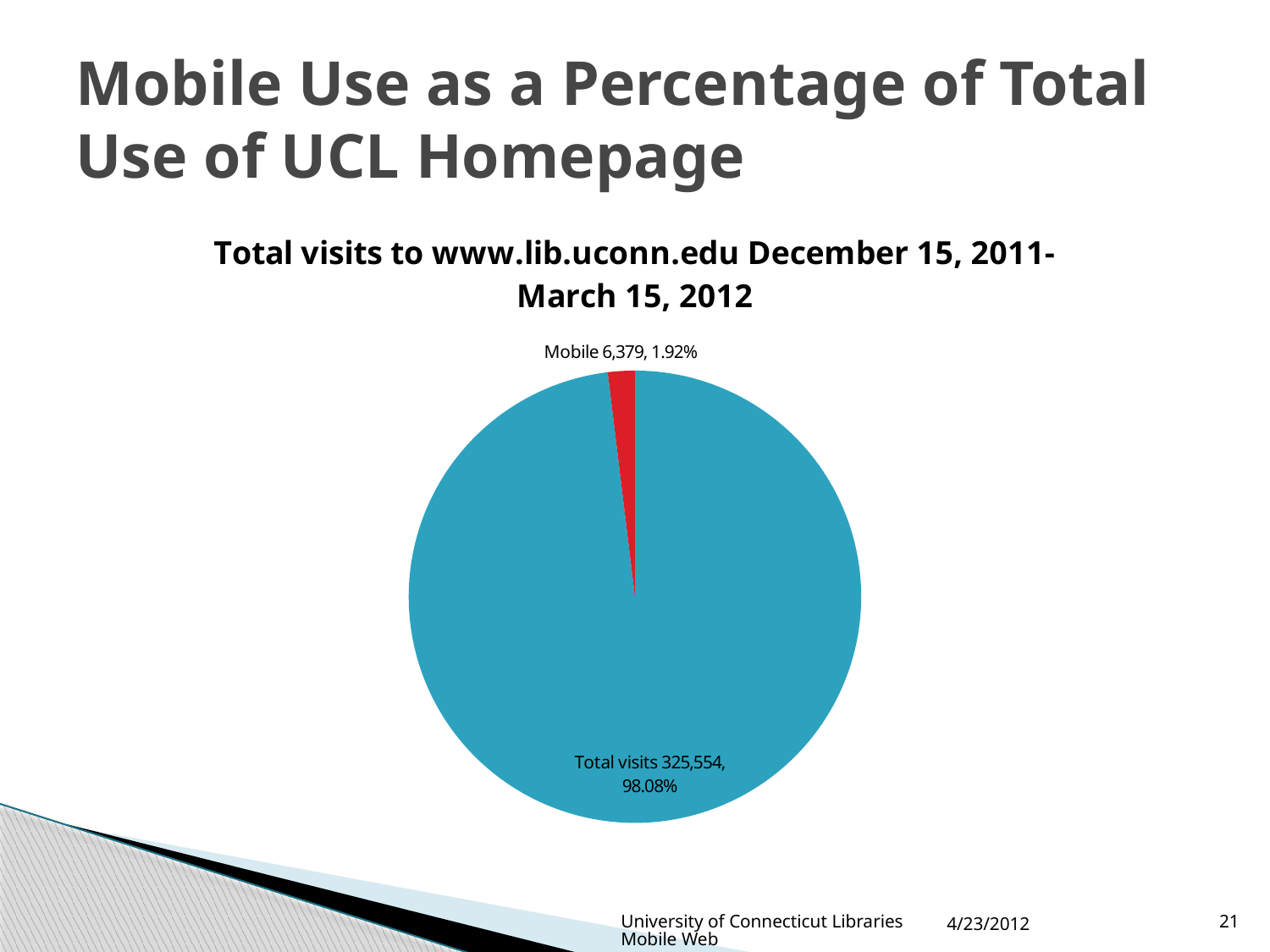
What percentage share of the pie does the Total visits slice represent? 98.08% Which slice is the largest in the pie chart? Total visits What is the title of the chart? Total visits to www.lib.uconn.edu December 15, 2011-March 15, 2012 Which slice is the smallest in the pie chart? Mobile Which is larger, the Mobile slice or the Total visits slice? Total visits What is the value shown for the Mobile slice? 6,379 What is the difference between the Total visits value and the Mobile value? 319,175 What kind of chart is shown on the slide? pie chart What percentage share of the pie does the Mobile slice represent? 1.92% How many slices does the pie chart have? 2 What is the value shown for the Total visits slice? 325,554 What colour is the Mobile slice in the pie chart? red